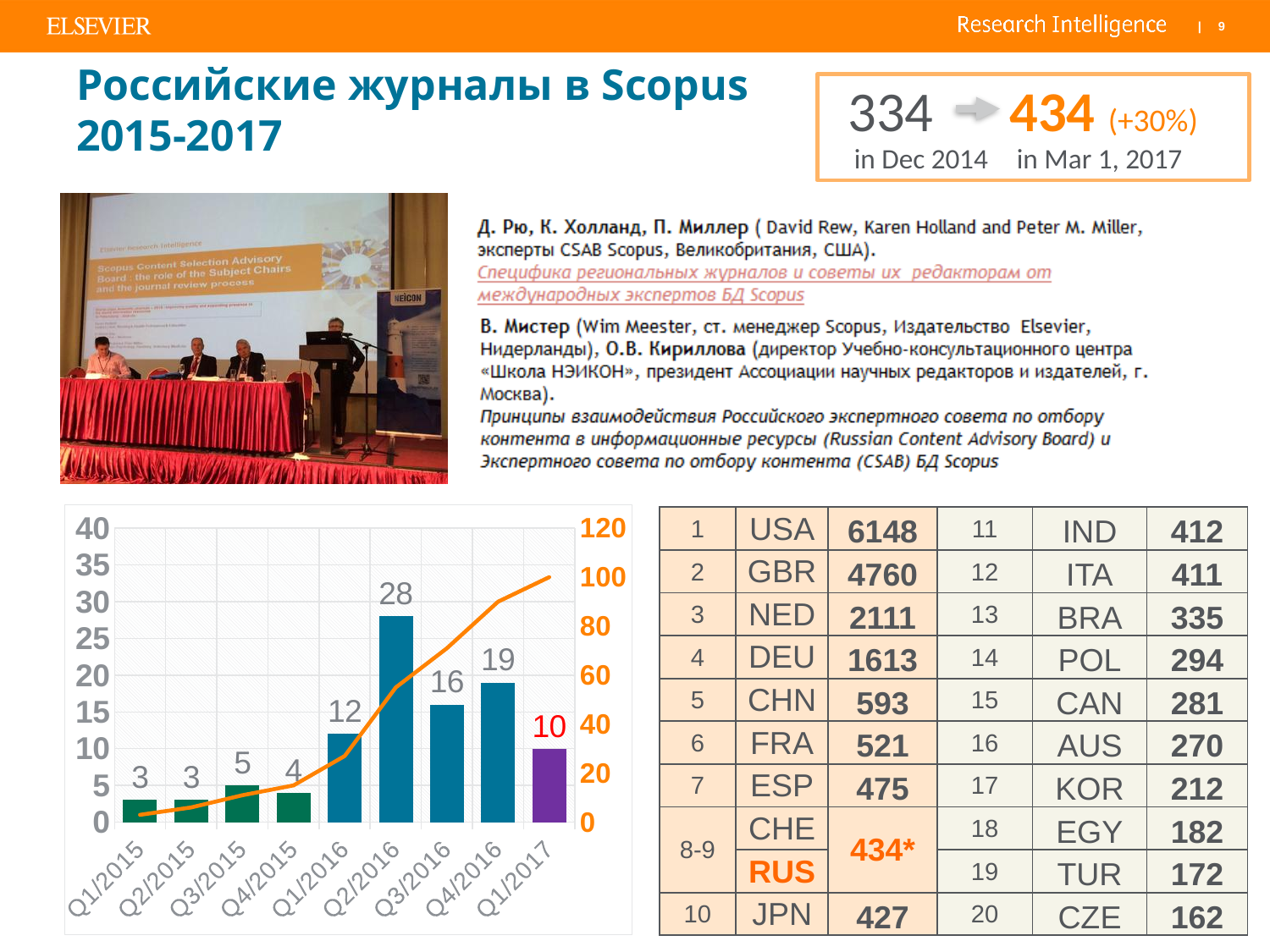
What colour is the bar for Q1/2017? purple Is the value of the line at Q1/2016 on the right axis greater or less than 40? less What is the value of the bar for Q1/2016? 12 What is the value of the bar for Q1/2017? 10 What is the difference between the bars for Q2/2016 and Q4/2016? 9 What is the value of the bar for Q2/2016? 28 How many quarters are shown on the x axis of the bar chart? 9 Do the bar values rise or fall from Q4/2015 to Q2/2016? rise Which bar is larger, Q3/2016 or Q4/2016? Q4/2016 What is the total of the bars for Q1/2015 through Q4/2015? 15 Which quarter has the highest bar? Q2/2016 Is the value of the line at Q1/2017 on the right axis greater or less than 80? greater